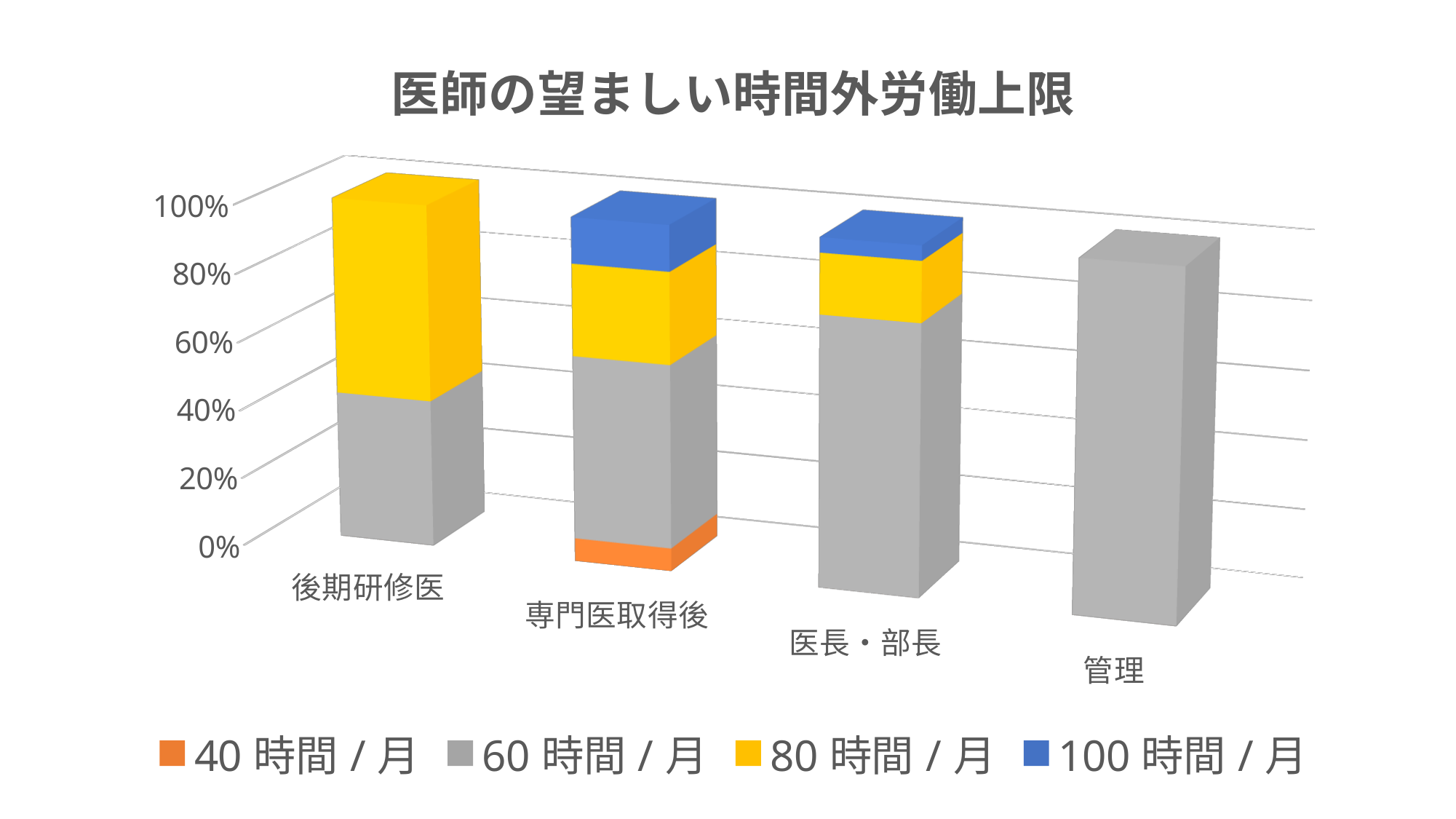
How many series does the legend list? 4 Which category is the only one with a 40 時間 / 月 segment? 専門医取得後 Is the share of 60 時間 / 月 for 後期研修医 greater or less than 60%? less Which category has the largest share for 60 時間 / 月? 管理 What kind of chart is shown on the slide? Stacked bar chart Which category has the largest share for 80 時間 / 月? 後期研修医 Is the share of 40 時間 / 月 for 専門医取得後 greater or less than 20%? less Which colour represents the 80 時間 / 月 series in the legend? Yellow Is the share of 60 時間 / 月 for 管理 greater or less than 80%? greater What is the title of the chart? 医師の望ましい時間外労働上限 Which is larger for 後期研修医, the 60 時間 / 月 share or the 80 時間 / 月 share? 80 時間 / 月 How many categories are shown on the x axis? 4